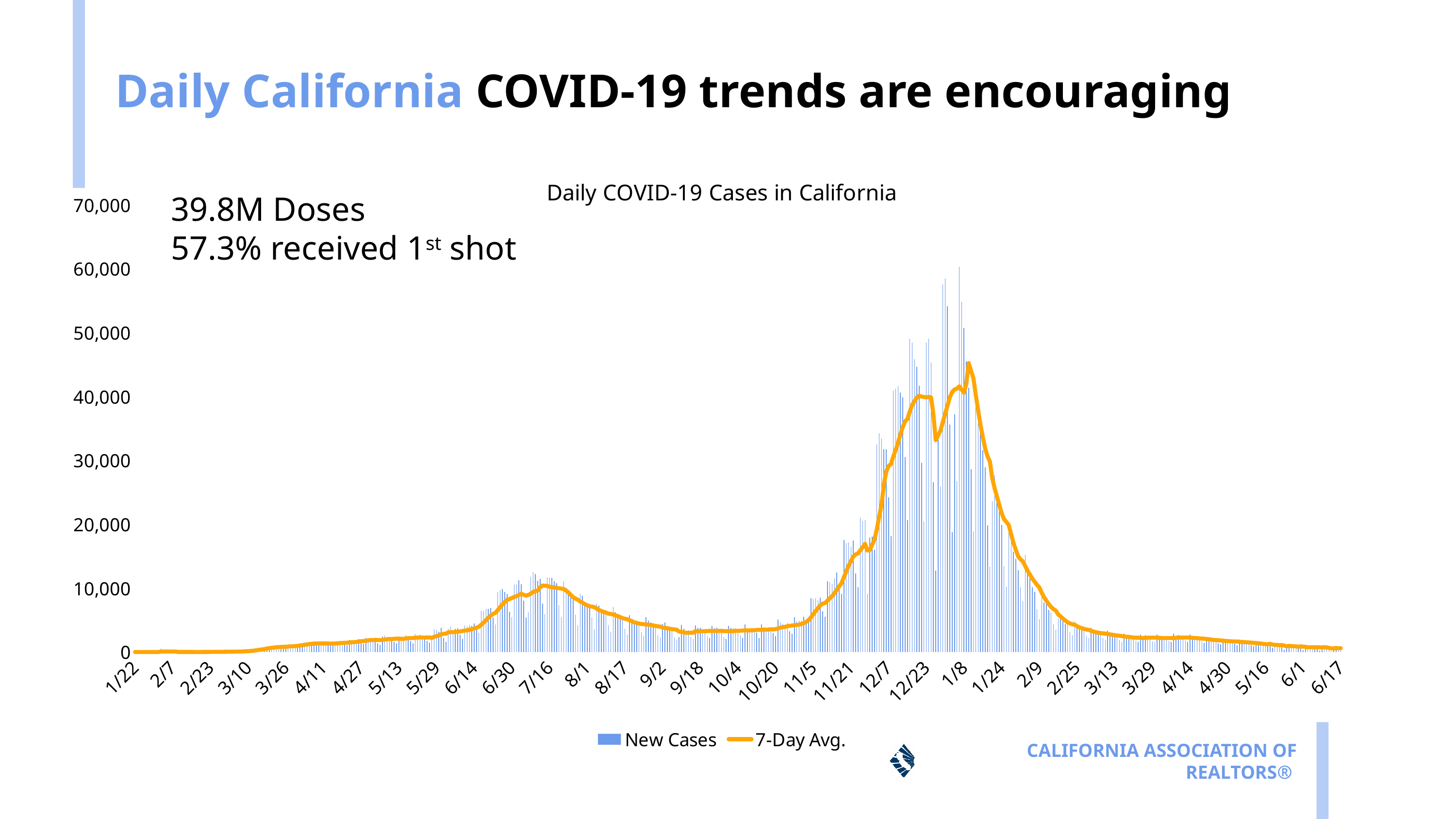
Which series is drawn as an orange line? 7-Day Avg. Which is larger, the 7-Day Avg. around 7/16 or the 7-Day Avg. around 1/8? 1/8 Is the 7-Day Avg. value around 7/16 greater or less than 20,000? less Does the 7-Day Avg. line rise or fall between 1/24 and 6/17? fall What is the title of the chart? Daily COVID-19 Cases in California Is the 7-Day Avg. value around 6/17 greater or less than 10,000? less What kind of chart is shown on the slide? A combination bar and line chart How many series does the chart legend list? 2 Is the 7-Day Avg. value around 9/18 greater or less than 10,000? less